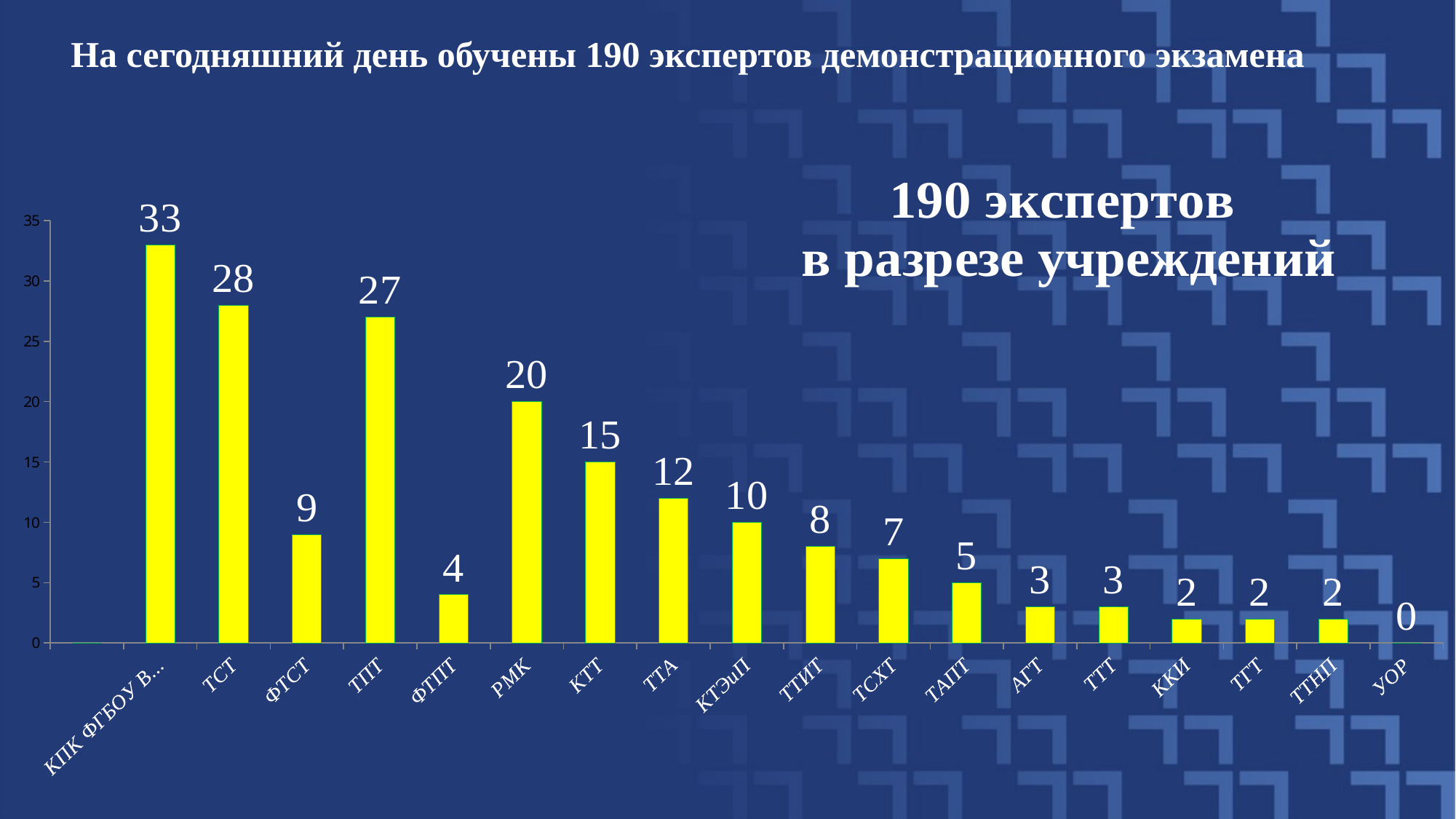
What colour are the bars in the chart? Yellow What is the value for ТСТ? 28 What kind of chart is shown on the slide? Bar chart What is the value for РМК? 20 What is the value for ТСХТ? 7 What is the difference between the values for ТПТ and ФТПТ? 23 Which category has the lowest value? УОР Which category has the highest value? КПК ФГБОУ В... How many categories are shown on the x axis? 18 What is the difference between the values for ТСТ and ТПТ? 1 What is the value for УОР? 0 Which is larger, the value for КТТ or the value for ТТА? КТТ